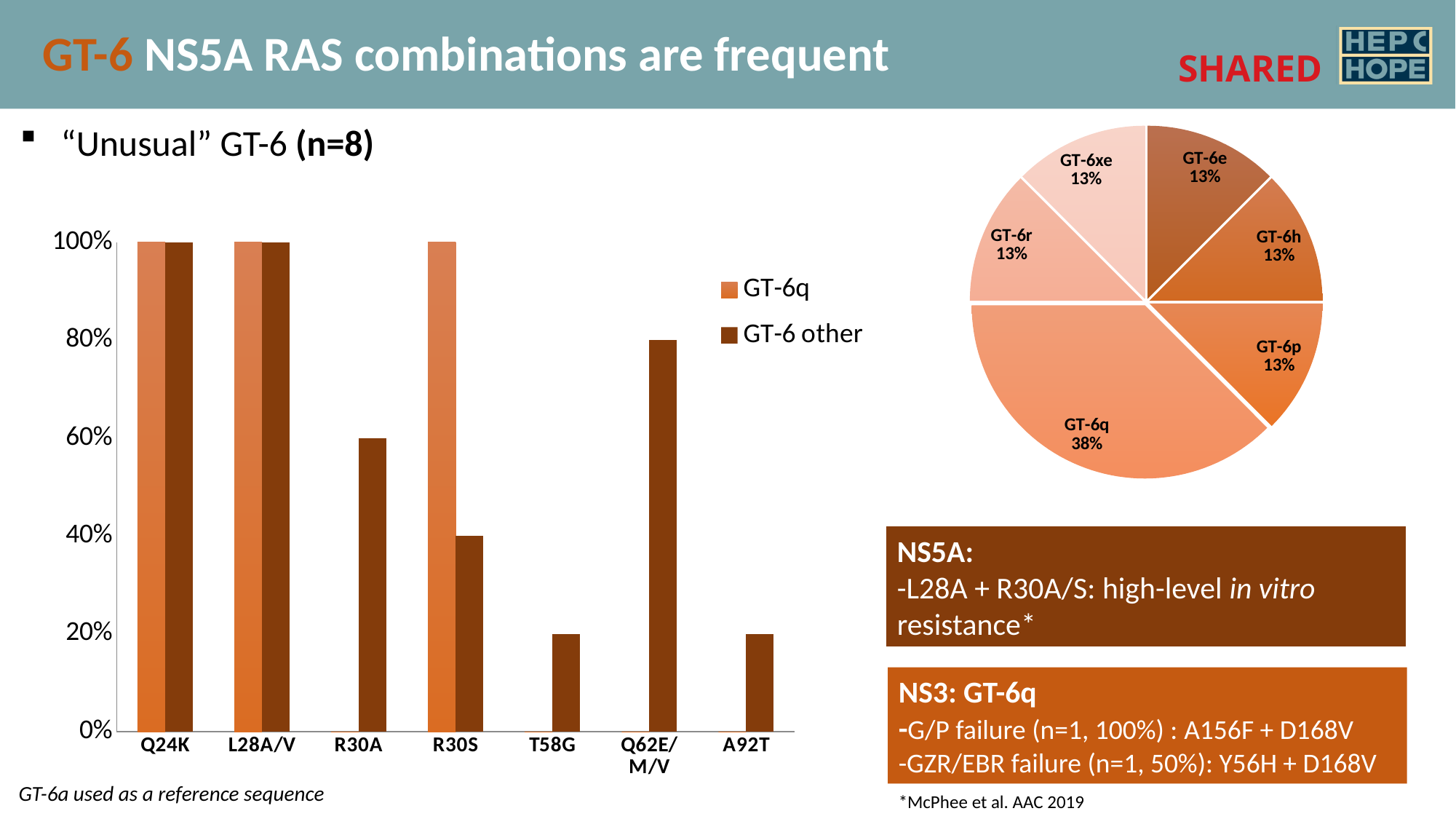
On the pie chart on the right, how many slices are there? 6 On the bar chart on the left, is the value for GT-6 other at T58G greater or less than 40%? less On the bar chart on the left, how many categories are shown on the x axis? 7 On the bar chart on the left, what kind of chart is it? bar chart On the pie chart on the right, which slice has the largest share? GT-6q On the bar chart on the left, what is the difference between GT-6q and GT-6 other at R30S? 60% On the bar chart on the left, how many series does the legend list? 2 On the bar chart on the left, which is larger at R30S, GT-6q or GT-6 other? GT-6q On the bar chart on the left, what is the value for GT-6 other at Q62E/M/V? 80% On the bar chart on the left, what is the value for GT-6 other at R30A? 60% On the bar chart on the left, what is the value for GT-6q at R30S? 100% On the pie chart on the right, what share does GT-6p have? 13%